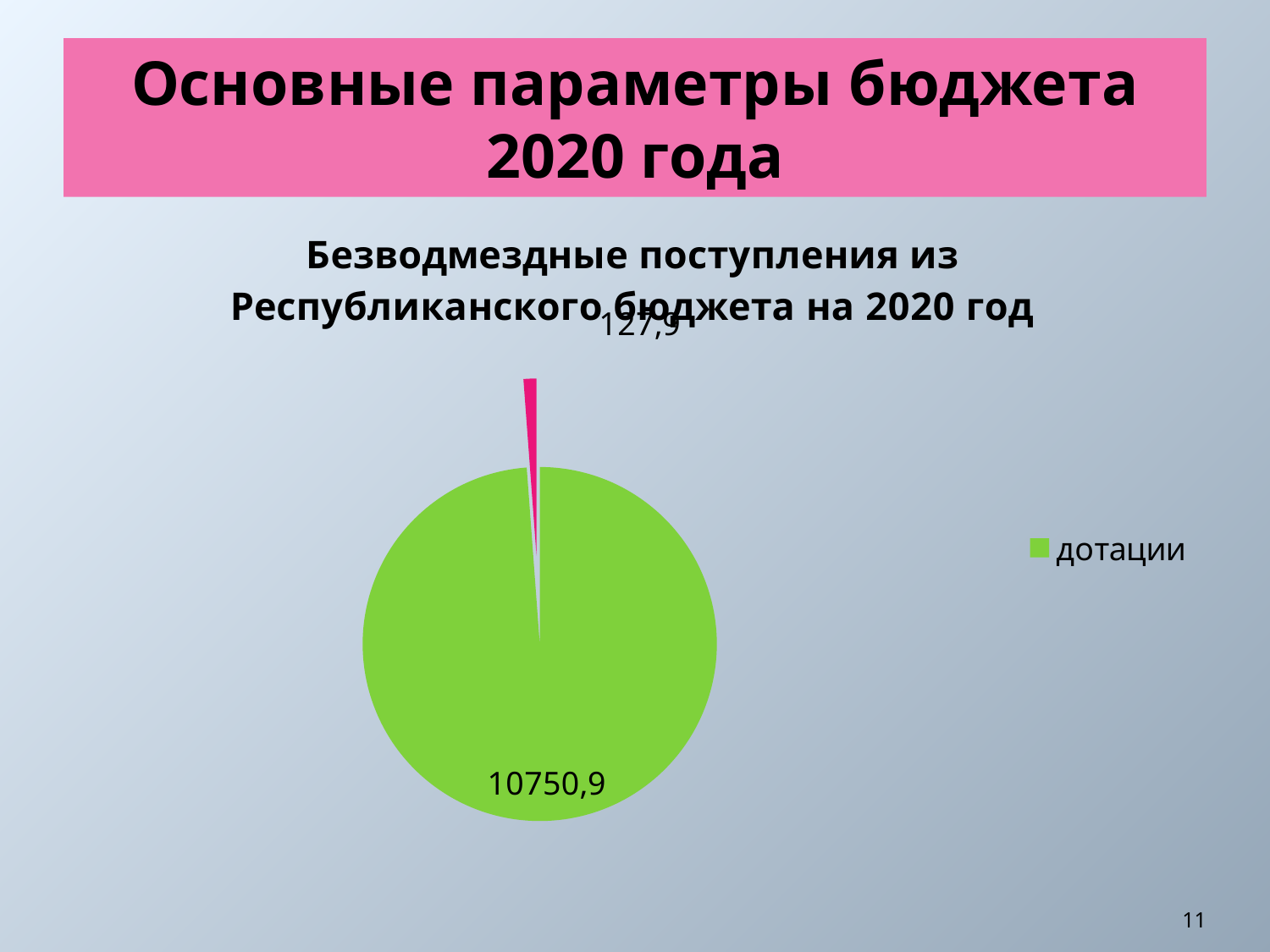
What kind of chart is shown on the slide? pie chart What is the total of the two values shown in the pie chart? 10878,8 Which slice of the pie chart is the smallest, the green one or the pink one? the pink one What is the title of the pie chart? Безводмездные поступления из Республиканского бюджета на 2020 год Is the дотации slice larger or smaller than the pink slice? larger Which slice of the pie chart is the largest? дотации What is the value of the дотации slice in the pie chart? 10750,9 How many entries does the legend of the pie chart list? 1 How many slices does the pie chart have? 2 What is the difference between the дотации value (10750,9) and the pink slice value (127,9)? 10623 What value is printed for the small pink slice of the pie chart? 127,9